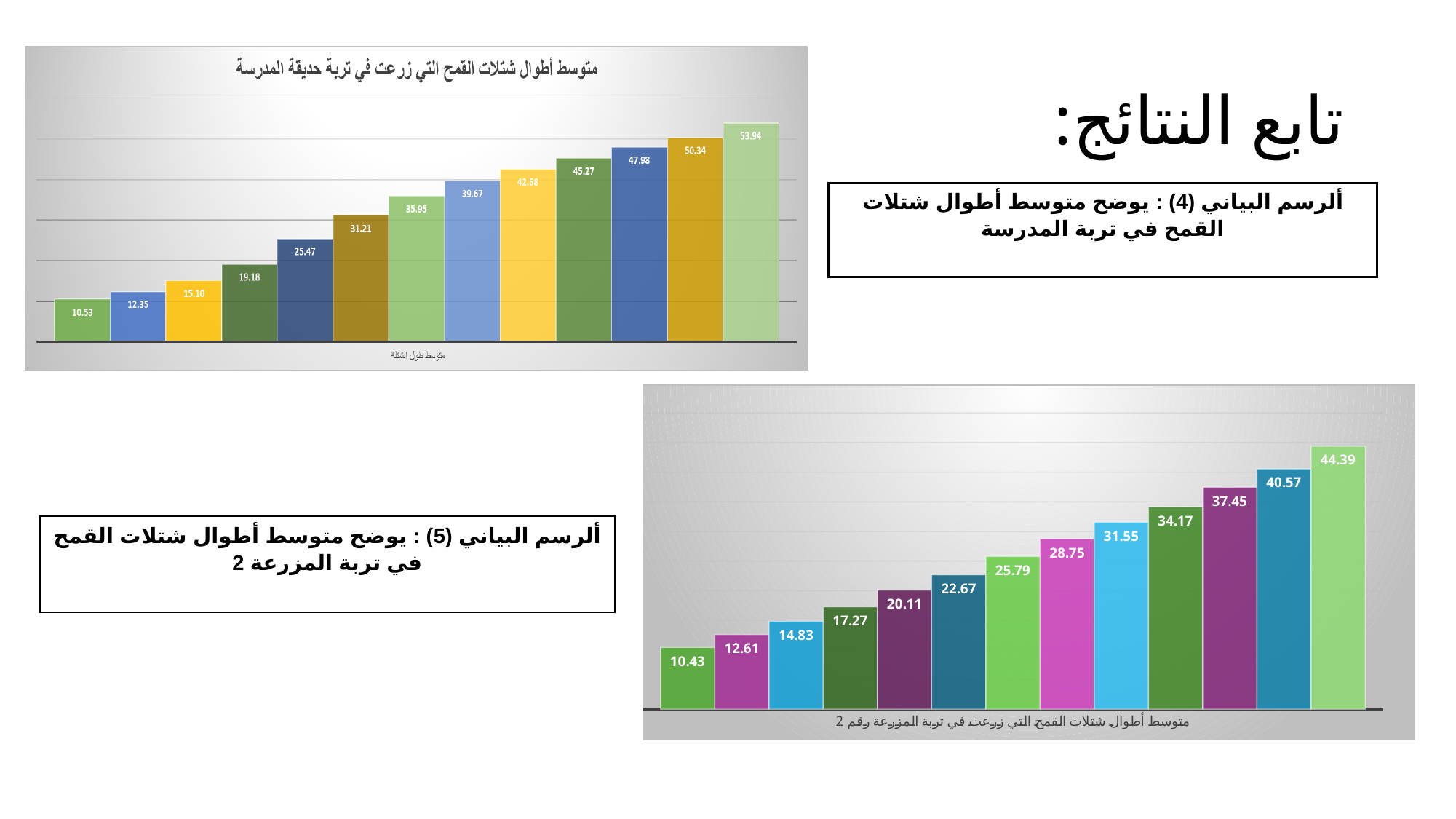
How many bars are plotted in the bottom-right chart (farm soil no. 2)? 13 What kind of chart is the bottom-right chart (farm soil no. 2)? Bar chart Which chart has the larger maximum value: the top-left chart (school garden soil) or the bottom-right chart (farm soil no. 2)? The top-left chart (school garden soil) In the bottom-right chart (farm soil no. 2), what is the value of the shortest bar? 10.43 In the top-left chart (school garden soil), what is the difference between the tallest and shortest bars? 43.41 In the bottom-right chart (farm soil no. 2), what is the value of the tallest bar? 44.39 In the bottom-right chart (farm soil no. 2), what is the value of the fifth bar from the left? 20.11 In the top-left chart (school garden soil), do the values rise or fall from left to right? Rise In the top-left chart (school garden soil), what is the value of the tallest bar? 53.94 In the top-left chart (school garden soil), what is the value of the shortest bar? 10.53 How many bars are plotted in the top-left chart (school garden soil)? 13 In the bottom-right chart (farm soil no. 2), what is the difference between the tallest and shortest bars? 33.96